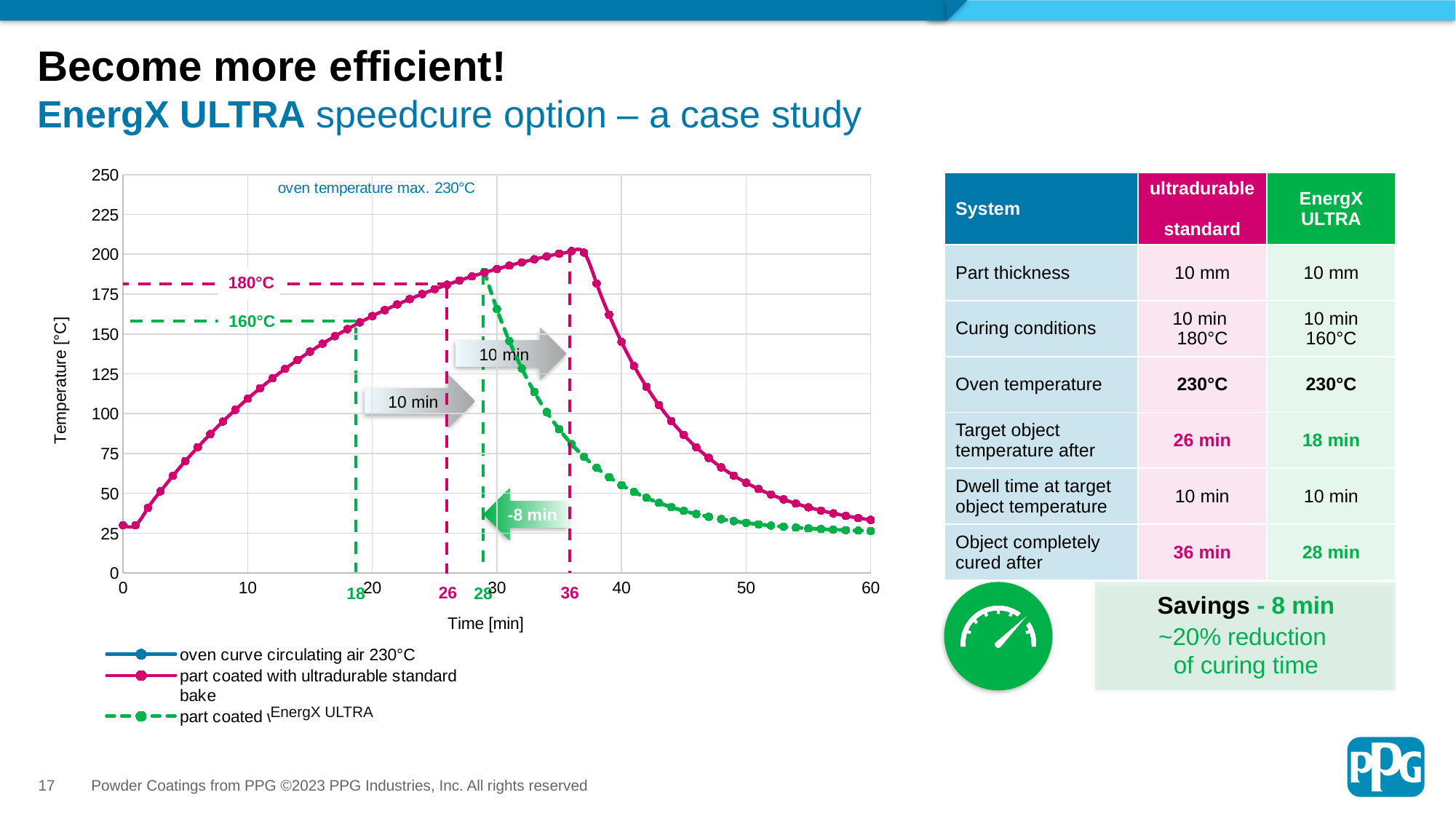
According to the chart annotations, at what time does the part coated with ultradurable standard bake reach 180°C? 26 min Is the temperature of the ultradurable standard part at 60 min greater or less than 50°C? less Between 0 and 30 min, does the temperature of the ultradurable standard part rise or fall? rise How many series does the chart legend list? 3 At what time on the x axis does the dashed green line mark the end of curing for the EnergX ULTRA part? 28 min At 40 min, which curve shows the higher temperature: the ultradurable standard part or the EnergX ULTRA part? ultradurable standard part What is the label of the chart's x axis? Time [min] What maximum oven temperature is noted at the top of the chart? 230°C At what time on the x axis does the dashed magenta line mark the end of curing for the ultradurable standard part? 36 min What is the difference between the 36 min and 28 min marks on the chart's x axis? 8 min What kind of chart is shown on the slide? line chart According to the chart annotations, at what time does the part coated with EnergX ULTRA reach 160°C? 18 min